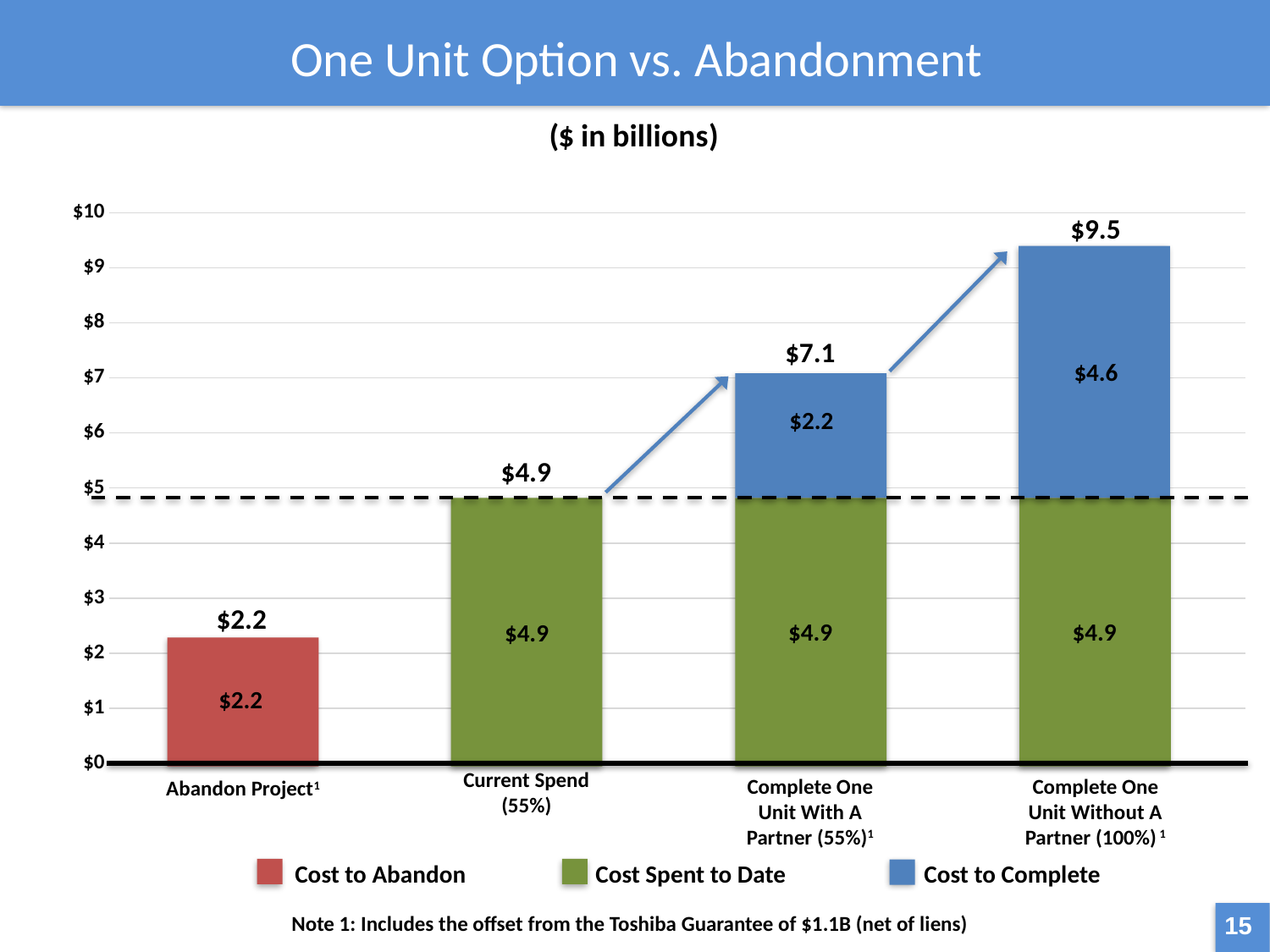
What kind of chart is shown on the slide? Stacked bar chart Which is larger: the Cost to Complete for Complete One Unit Without A Partner (100%) or the Cost to Complete for Complete One Unit With A Partner (55%)? Complete One Unit Without A Partner (100%) What is the Cost to Abandon value for Abandon Project? $2.2 What is the Cost Spent to Date value for Current Spend (55%)? $4.9 Which category has the lowest total value? Abandon Project How many series does the legend list? 3 What is the total value shown for Complete One Unit Without A Partner (100%)? $9.5 What is the difference between the total for Complete One Unit Without A Partner (100%) and the total for Complete One Unit With A Partner (55%)? $2.4 Which category has the highest total value? Complete One Unit Without A Partner (100%) How many categories are shown on the x axis? 4 What unit is stated in the chart subtitle? $ in billions What is the Cost to Complete value for Complete One Unit With A Partner (55%)? $2.2